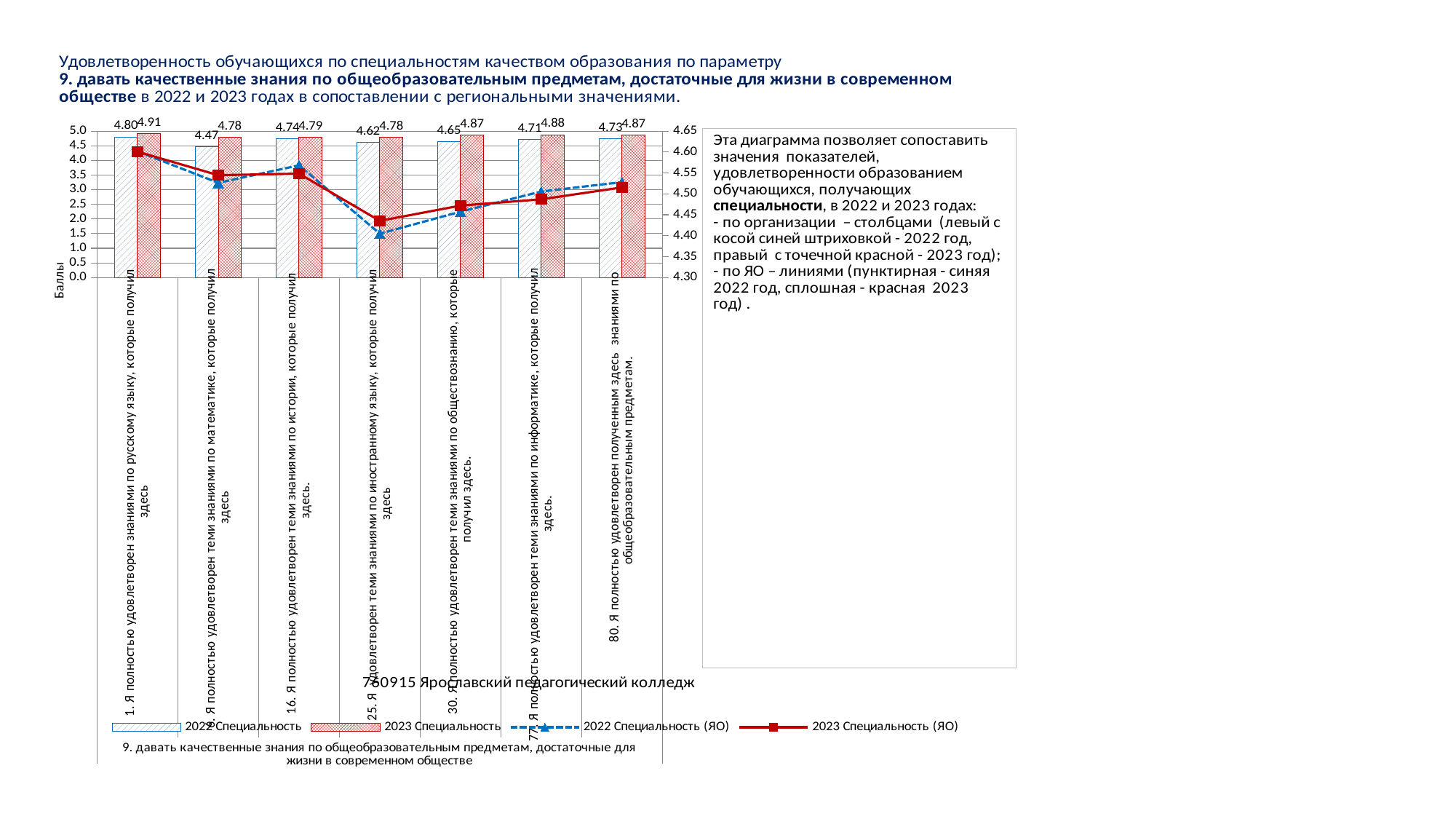
Which category has the highest 2023 Специальность bar? 1. Я полностью удовлетворен знаниями по русскому языку, которые получил здесь What is the difference between the 2023 and 2022 Специальность values for Russian language (русскому языку)? 0.11 Which is larger: the 2023 Специальность value for social studies (обществознанию) or for foreign language (иностранному языку)? обществознанию (4.87) What is the 2023 Специальность value for the category about knowledge of informatics (информатике)? 4.88 What is the 2022 Специальность value for the category about knowledge of mathematics (математике)? 4.47 By how much did the Специальность value for mathematics (математике) increase from 2022 to 2023? 0.31 What is the 2023 Специальность value for the category about knowledge of Russian language (русскому языку)? 4.91 How many series does the chart legend list? 4 How many categories are shown on the x axis of the chart? 7 Is the 2022 Специальность (ЯО) line value for foreign language (иностранному языку) greater or less than 4.50 on the right axis? less What is the 2022 Специальность value for the category about social studies (обществознанию)? 4.65 Which category has the lowest 2022 Специальность bar? Я полностью удовлетворен теми знаниями по математике, которые получил здесь